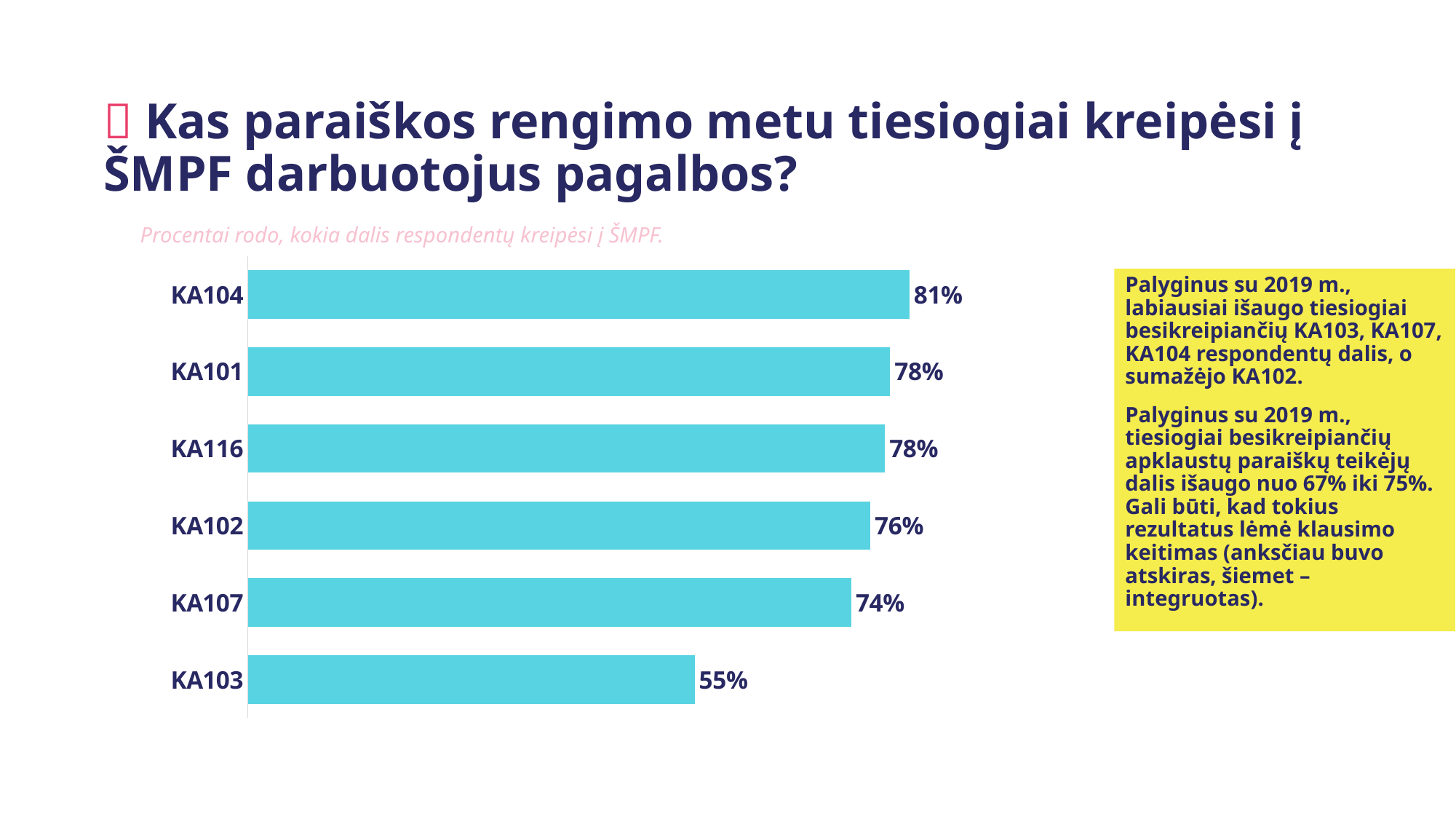
Which is larger, the value for KA102 or the value for KA107? KA102 What is the difference between the values for KA101 and KA107? 4% What kind of chart is shown on the slide? Bar chart Which two categories share the same value of 78%? KA101 and KA116 Which category has the lowest value? KA103 What is the value for KA104? 81% What is the difference between the values for KA104 and KA103? 26% What is the value for KA107? 74% How many categories are shown in the chart? 6 Which category has the highest value? KA104 What is the value for KA102? 76% What is the value for KA103? 55%